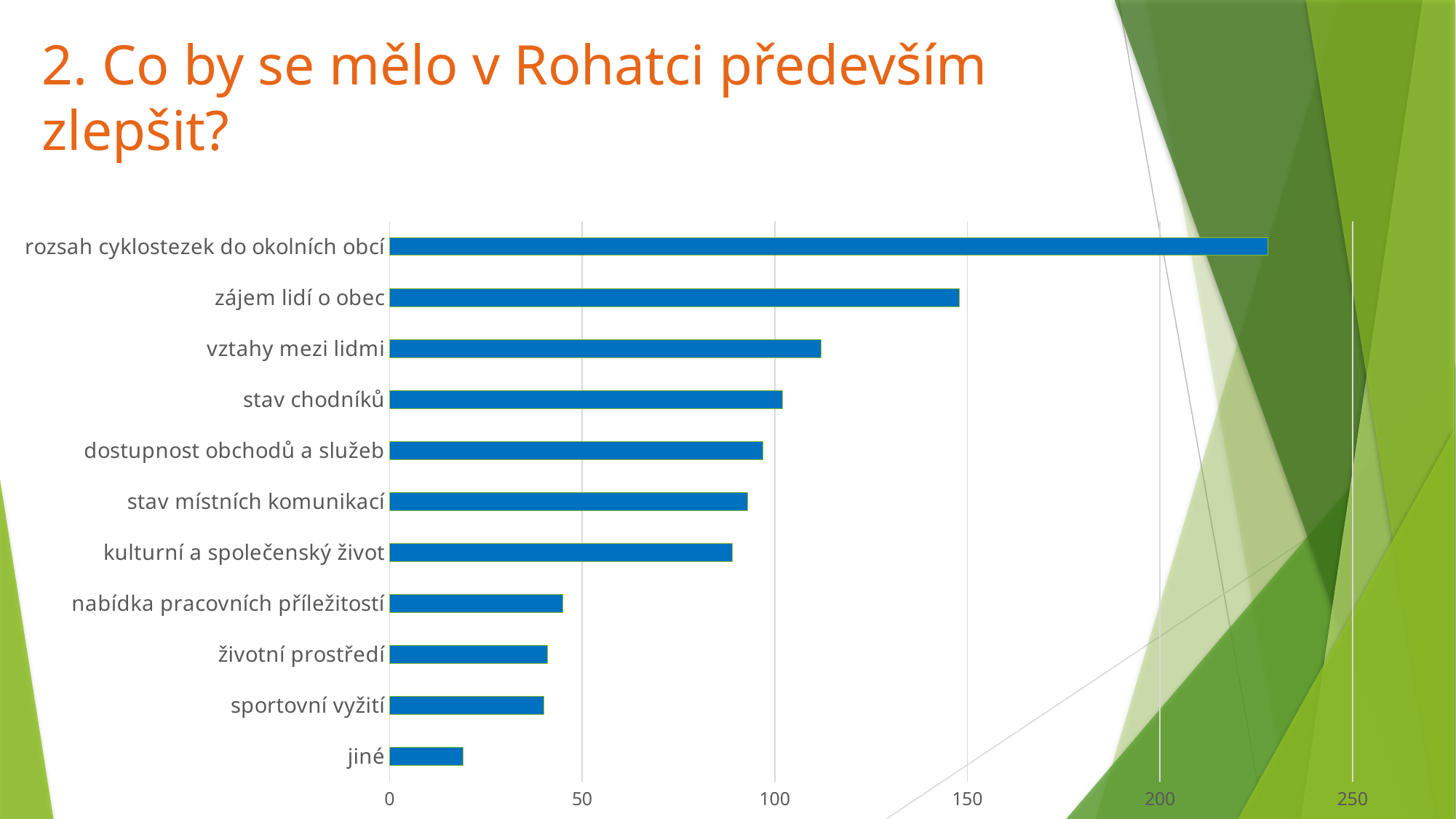
Which is larger, the value for zájem lidí o obec or the value for stav chodníků? zájem lidí o obec What is the title of the slide containing the chart? 2. Co by se mělo v Rohatci především zlepšit? Is the value for rozsah cyklostezek do okolních obcí greater or less than 200? greater Is the value for vztahy mezi lidmi greater or less than 100? greater Which is larger, the value for sportovní vyžití or the value for jiné? sportovní vyžití Which category has the lowest value? jiné Is the value for nabídka pracovních příležitostí greater or less than 50? less Which category has the highest value? rozsah cyklostezek do okolních obcí What kind of chart is shown on the slide? bar chart How many categories are plotted in the chart? 11